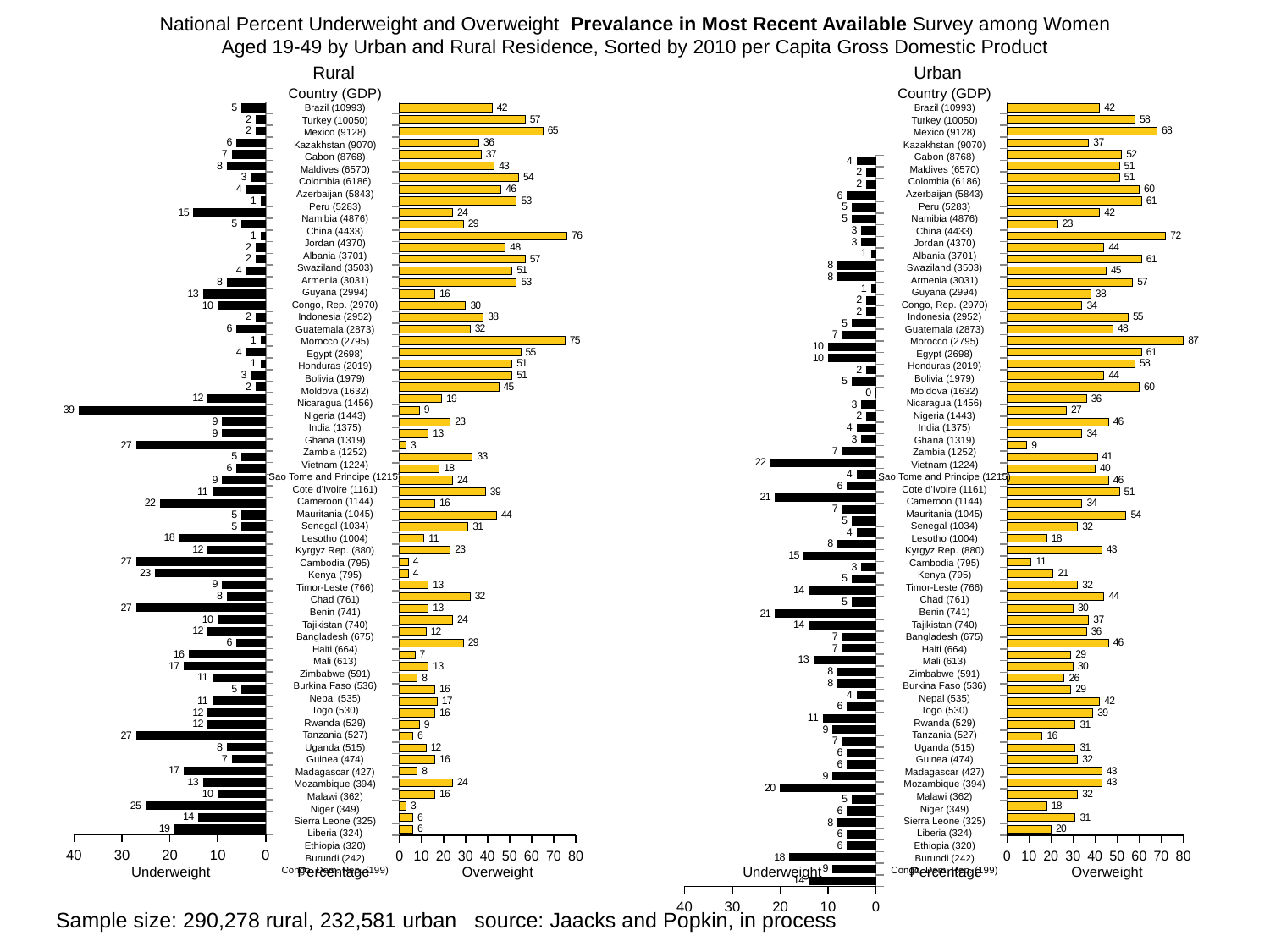
In the Urban chart, which is larger: the overweight percentage for Mexico (9128) or for Turkey (10050)? Mexico (9128) What kind of chart is used on this slide? Bar chart What is the rural sample size stated on the slide? 290,278 In the Rural chart, what is the overweight percentage for Brazil (10993)? 42